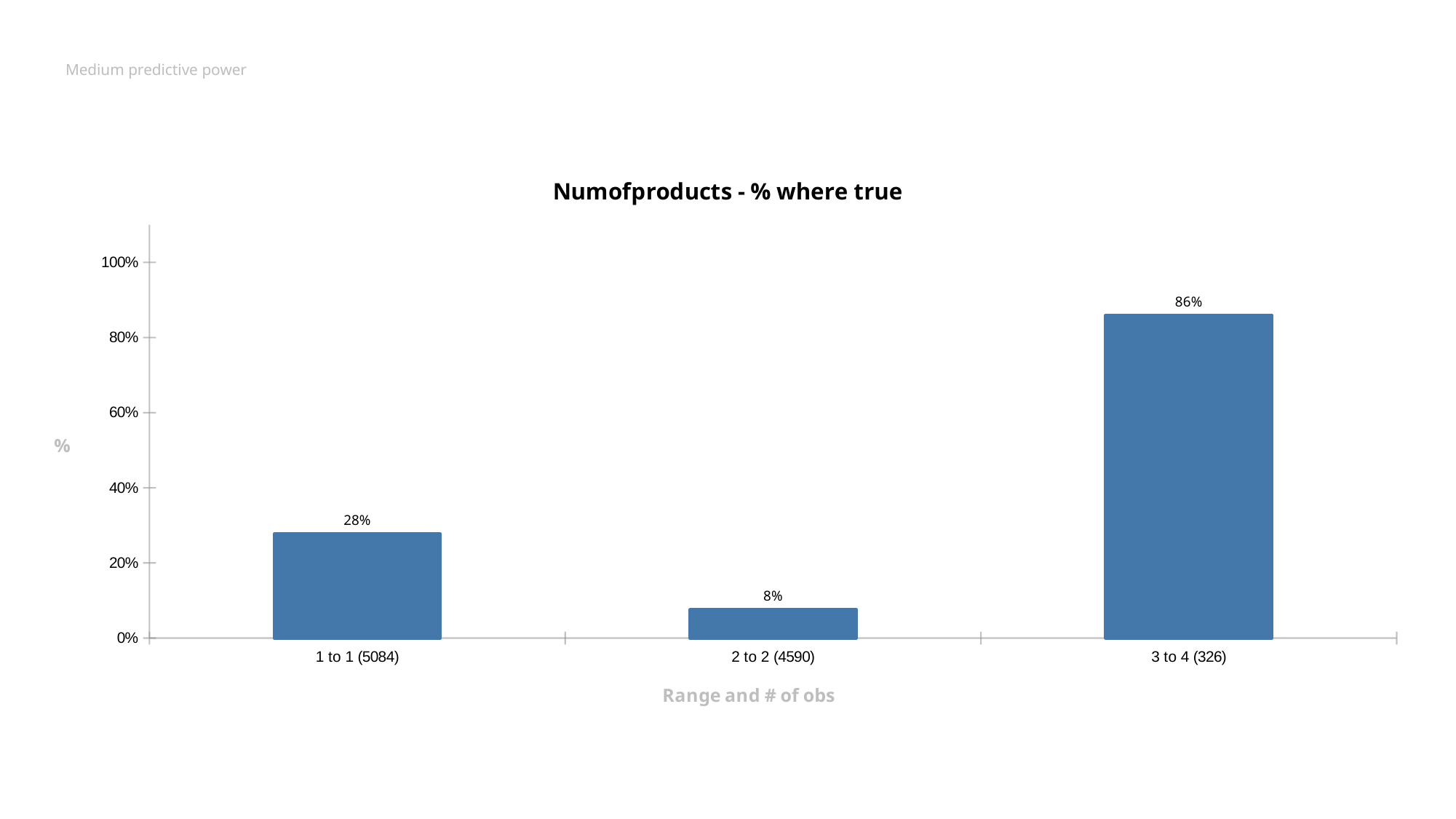
What is the value for the category "3 to 4 (326)"? 86% What kind of chart is shown on the slide? bar chart Which category has the highest value? 3 to 4 (326) How many categories are shown on the x axis? 3 What is the difference between the values for "1 to 1 (5084)" and "2 to 2 (4590)"? 20% What is the title of the chart? Numofproducts - % where true Which is larger, the value for "1 to 1 (5084)" or the value for "2 to 2 (4590)"? 1 to 1 (5084) What is the difference between the values for "3 to 4 (326)" and "1 to 1 (5084)"? 58% What is the value for the category "2 to 2 (4590)"? 8% What is the value for the category "1 to 1 (5084)"? 28% Is the value for "3 to 4 (326)" greater or less than 80%? greater Which category has the lowest value? 2 to 2 (4590)